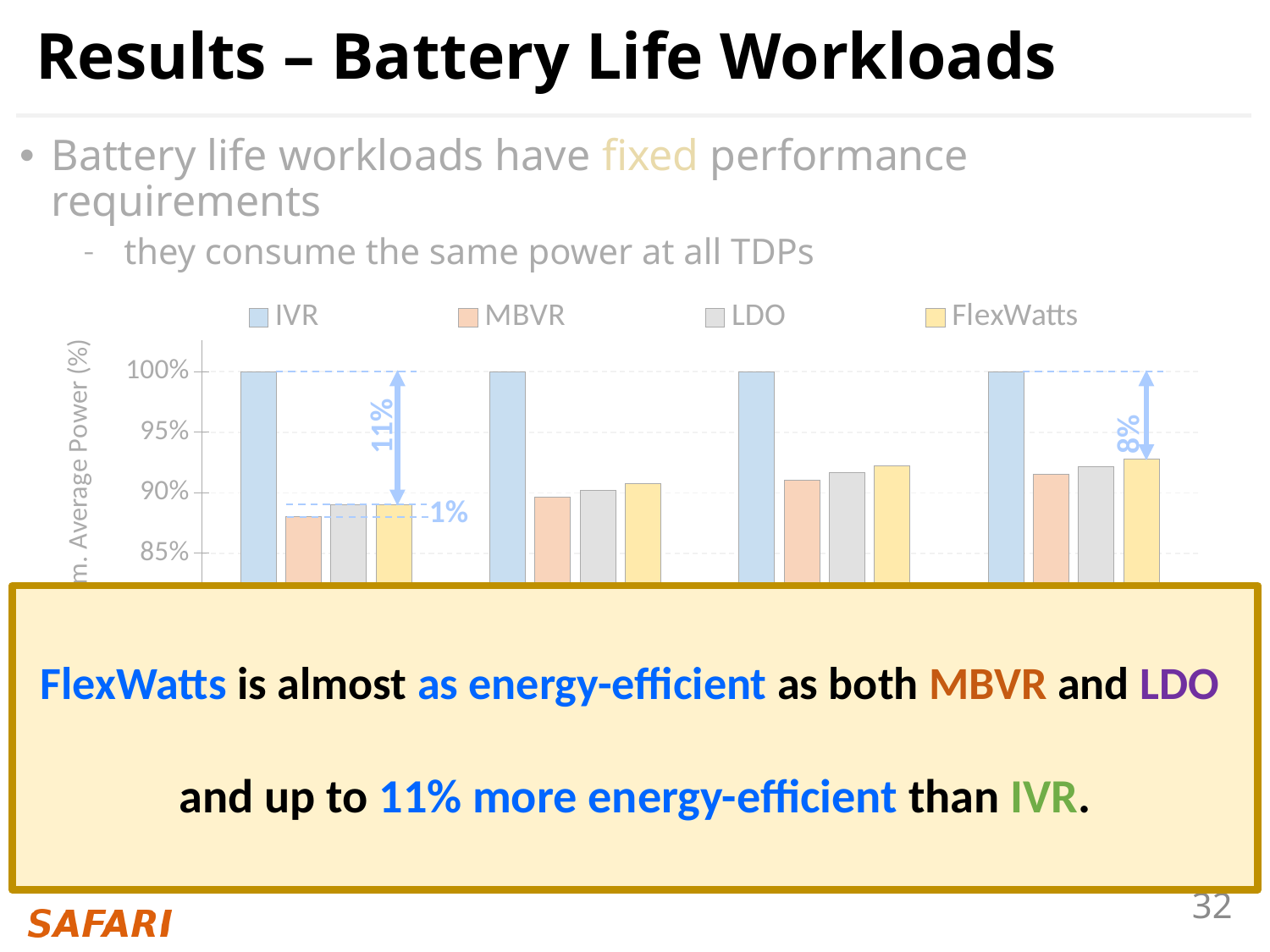
Is the MBVR value in the leftmost group greater or less than 90%? less How many series does the chart legend list? 4 Which series has the lowest bar in the leftmost group? MBVR Which series has the highest bar in the leftmost group? IVR Is the FlexWatts value in the rightmost group greater or less than 90%? greater Which series is shown in yellow in the legend? FlexWatts How many groups of bars are plotted in the chart? 4 What is the value of the IVR bar in the leftmost group of bars? 100% In the rightmost group, which is larger: the FlexWatts bar or the MBVR bar? FlexWatts According to the annotation in the leftmost group, by how much is FlexWatts below IVR? 11% Do the FlexWatts values rise or fall from the leftmost group to the rightmost group? rise What kind of chart is shown on the slide? bar chart